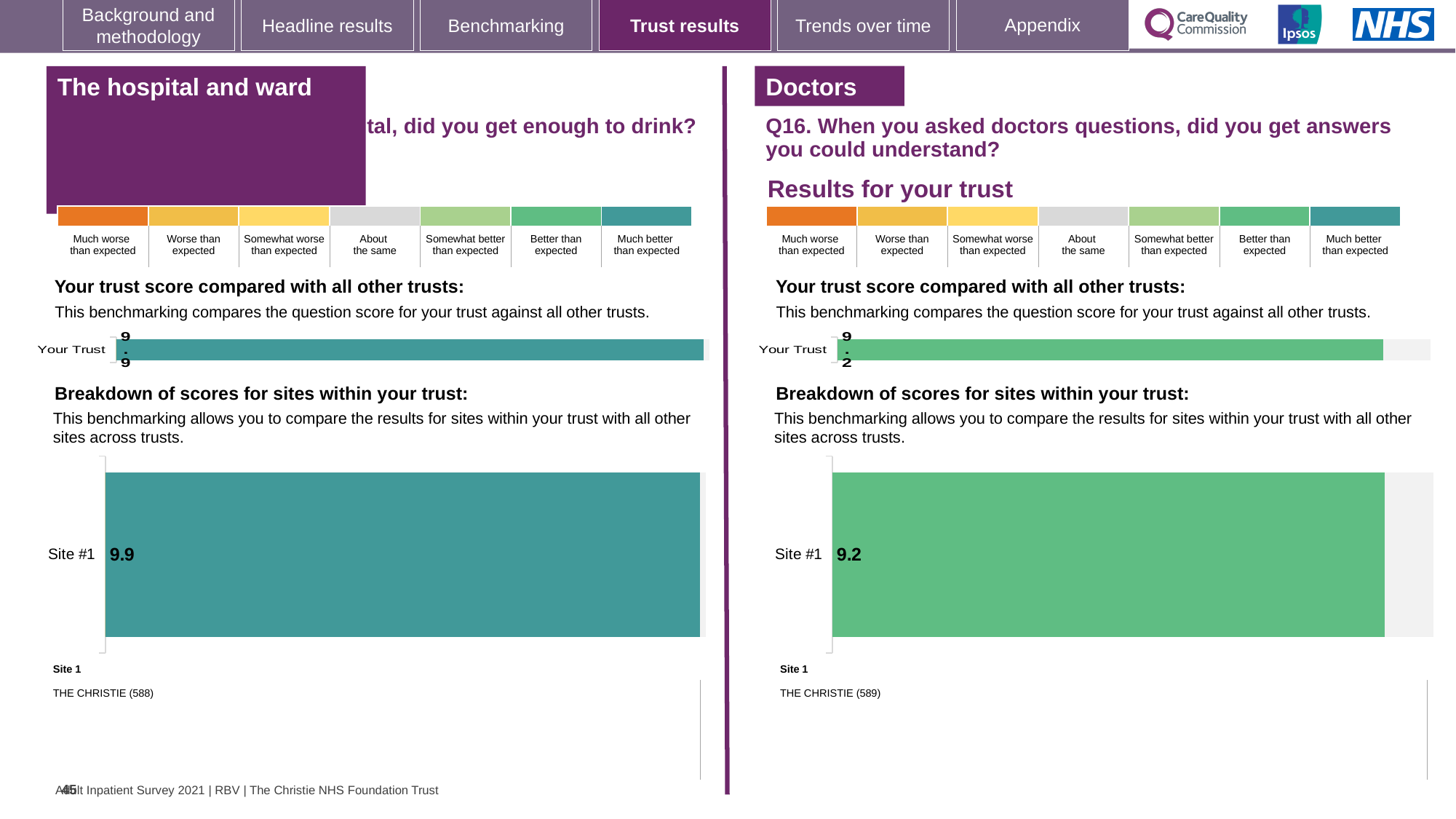
How many sites are shown in the left-hand 'Breakdown of scores for sites within your trust' chart? 1 What is the name of Site 1 listed under the left-hand site breakdown chart? THE CHRISTIE (588) How many categories are shown in the benchmark colour scale above the left-hand 'Your Trust' chart? 7 On the left-hand site breakdown chart, what is the score for Site #1? 9.9 On the right-hand 'Your Trust' bar chart (Doctors, Q16), what is the score shown for Your Trust? 9.2 What kind of chart is used to show the Site #1 score on the left-hand side of the slide? Bar chart On the right-hand site breakdown chart (Q16), what is the score for Site #1? 9.2 Is the Your Trust score on the right-hand (Q16) chart greater or less than 9? greater On the left-hand 'Your Trust' bar chart (The hospital and ward section), what is the score shown for Your Trust? 9.9 What is the difference between the Site #1 score on the left-hand chart (9.9) and the Site #1 score on the right-hand chart (9.2)? 0.7 Which is larger: the Your Trust score on the left-hand chart or the Your Trust score on the right-hand (Q16) chart? The left-hand chart (9.9) What colour is the Site #1 bar on the right-hand (Q16) site breakdown chart? Green